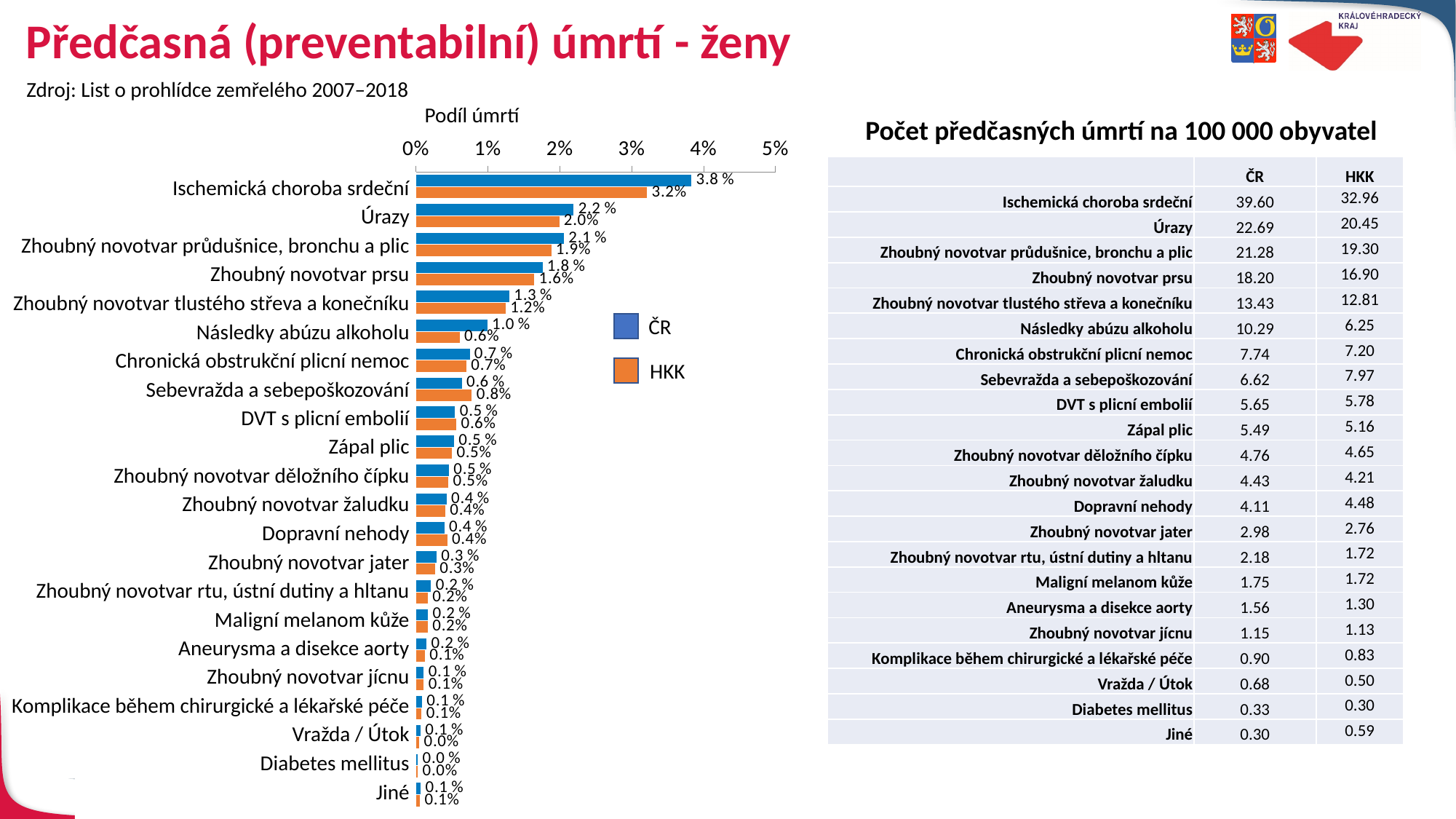
For Sebevražda a sebepoškozování, which series has the larger value in the chart, ČR or HKK? HKK What is the title of the chart? Podíl úmrtí What type of chart is shown on the slide? bar chart What is the HKK value for Úrazy in the chart? 2.0% What is the difference between the ČR and HKK values for Ischemická choroba srdeční in the chart? 0.6 % Is the ČR value for Ischemická choroba srdeční greater or less than 3%? greater What is the ČR value for Sebevražda a sebepoškozování in the chart? 0.6 % What is the HKK value for Následky abúzu alkoholu in the chart? 0.6% How many categories are shown in the chart? 22 What is the ČR value for Ischemická choroba srdeční in the chart? 3.8 % Which category has the highest ČR value in the chart? Ischemická choroba srdeční How many series does the chart legend list? 2